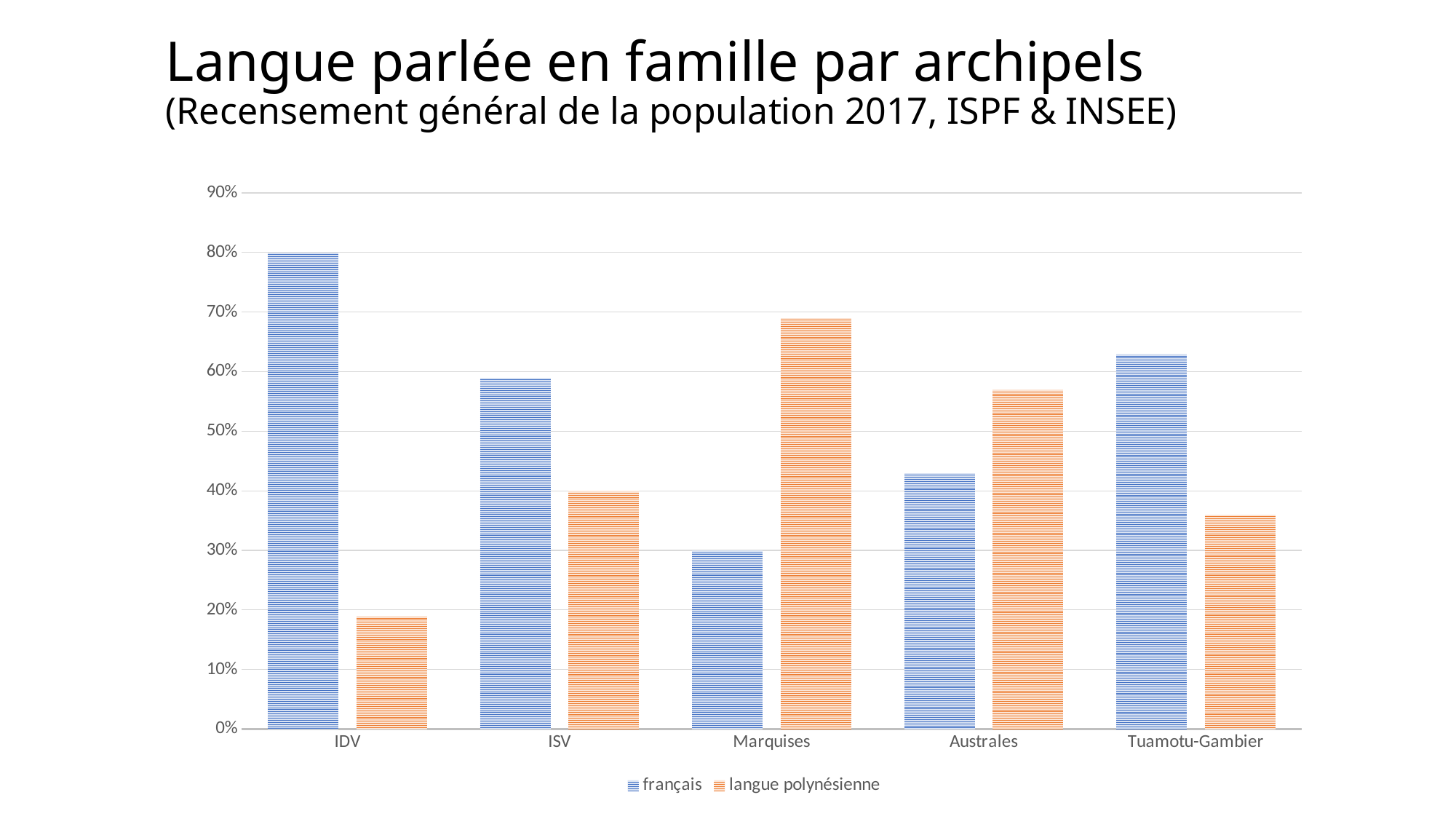
In ISV, which is larger: français or langue polynésienne? français Which archipelago has the highest value for langue polynésienne? Marquises How many series does the legend list? 2 Is the value for langue polynésienne in IDV greater or less than 20%? less In Australes, which is larger: français or langue polynésienne? langue polynésienne Is the value for français in Tuamotu-Gambier greater or less than 60%? greater Which archipelago has the lowest value for français? Marquises What kind of chart is shown on the slide? bar chart How many archipelago categories are shown on the x axis? 5 Which archipelago has the highest value for français? IDV Which series is shown in orange in the legend? langue polynésienne Which archipelago has the lowest value for langue polynésienne? IDV